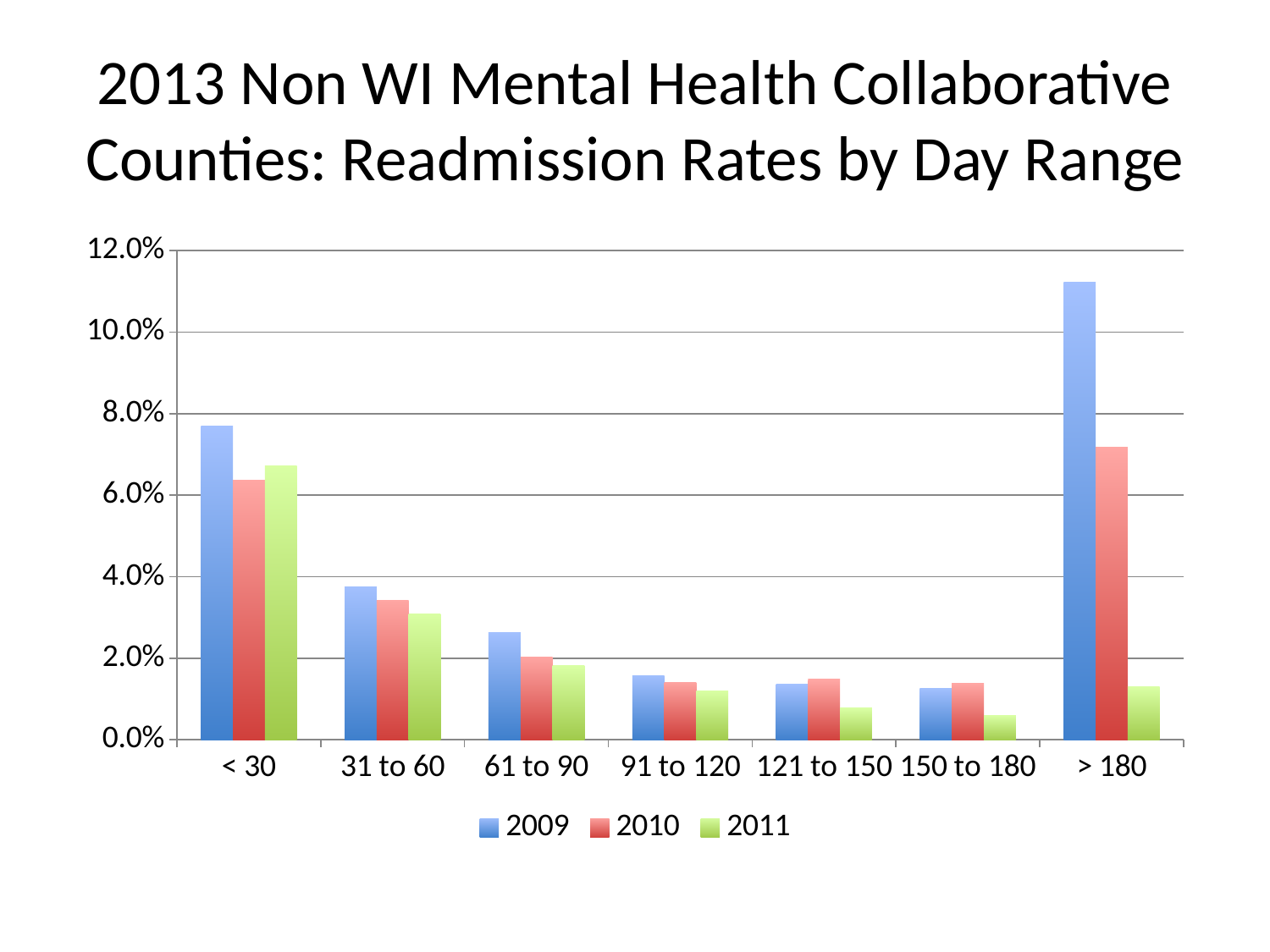
Is the 2011 value for > 180 greater or less than 2.0%? less Which day range has the highest readmission rate for 2009? > 180 Do the 2011 values rise or fall from < 30 through 150 to 180? fall Which years are listed in the legend? 2009, 2010, 2011 How many day-range categories are shown on the x axis? 7 For the > 180 day range, which year has the larger readmission rate, 2009 or 2011? 2009 Which day range has the lowest readmission rate for 2011? 150 to 180 Is the 2009 value for > 180 greater or less than 10.0%? greater What kind of chart is shown on the slide? bar chart How many series does the legend list? 3 Is the 2010 value for < 30 greater or less than 6.0%? greater Which day range has the highest readmission rate for 2011? < 30